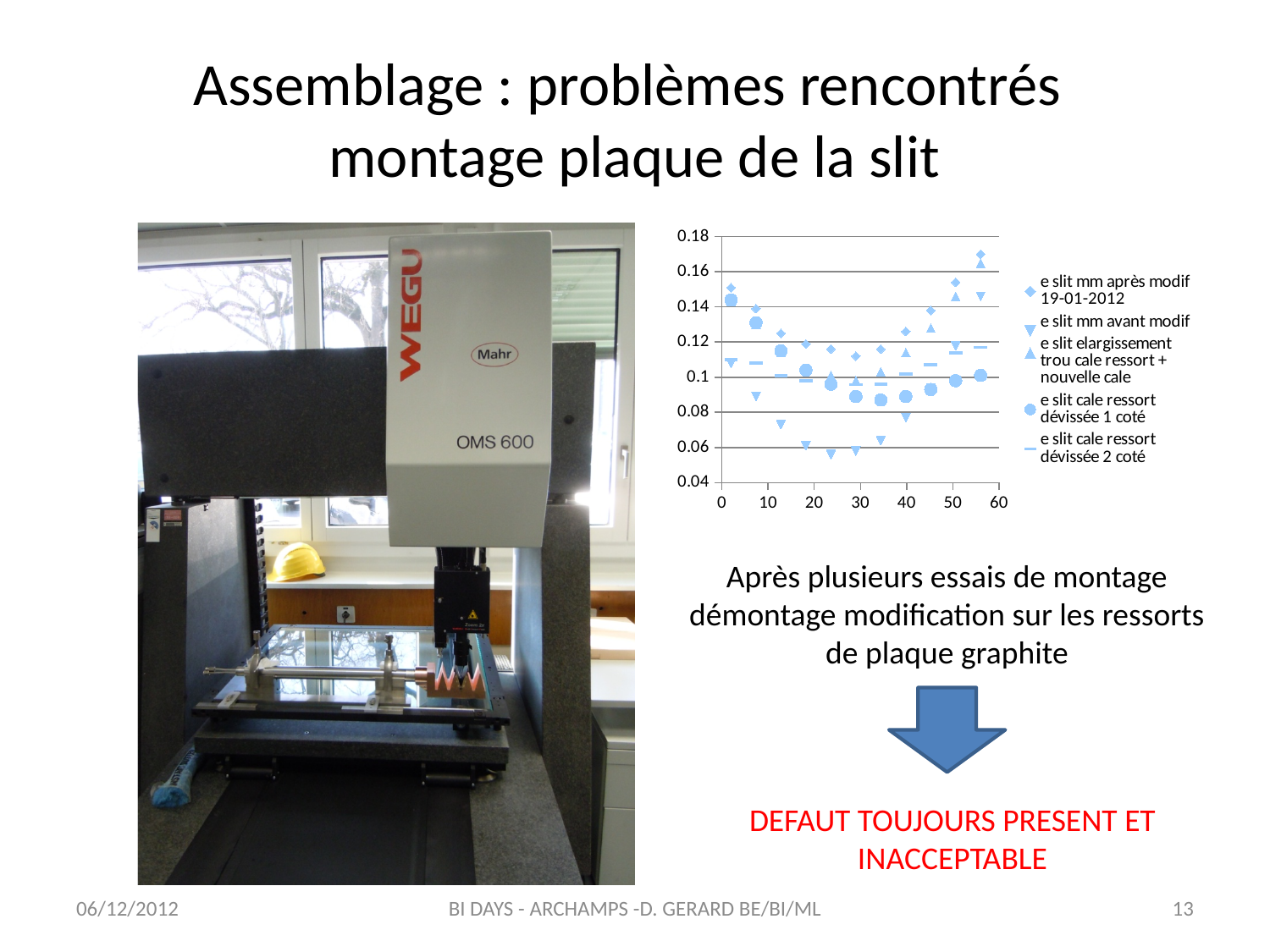
Is the value of the 'e slit mm après modif 19-01-2012' series at its last point (around x = 56) greater or less than 0.16? greater How many series does the chart legend list? 5 Which series reaches the highest point on the chart? e slit mm après modif 19-01-2012 Is the value of the 'e slit mm avant modif' series at its first point (around x = 2) greater or less than 0.14? less What kind of chart is shown on the slide? scatter chart At around x = 56, which series has the larger value: 'e slit mm après modif 19-01-2012' or 'e slit cale ressort dévissée 1 coté'? e slit mm après modif 19-01-2012 What is the highest value shown on the chart's horizontal axis? 60 Which series contains the lowest point on the chart? e slit mm avant modif Is the value of the 'e slit mm avant modif' series at around x = 13 greater or less than 0.08? less What is the highest value shown on the chart's vertical axis? 0.18 Does the 'e slit mm avant modif' series rise or fall between x = 0 and x = 30? fall